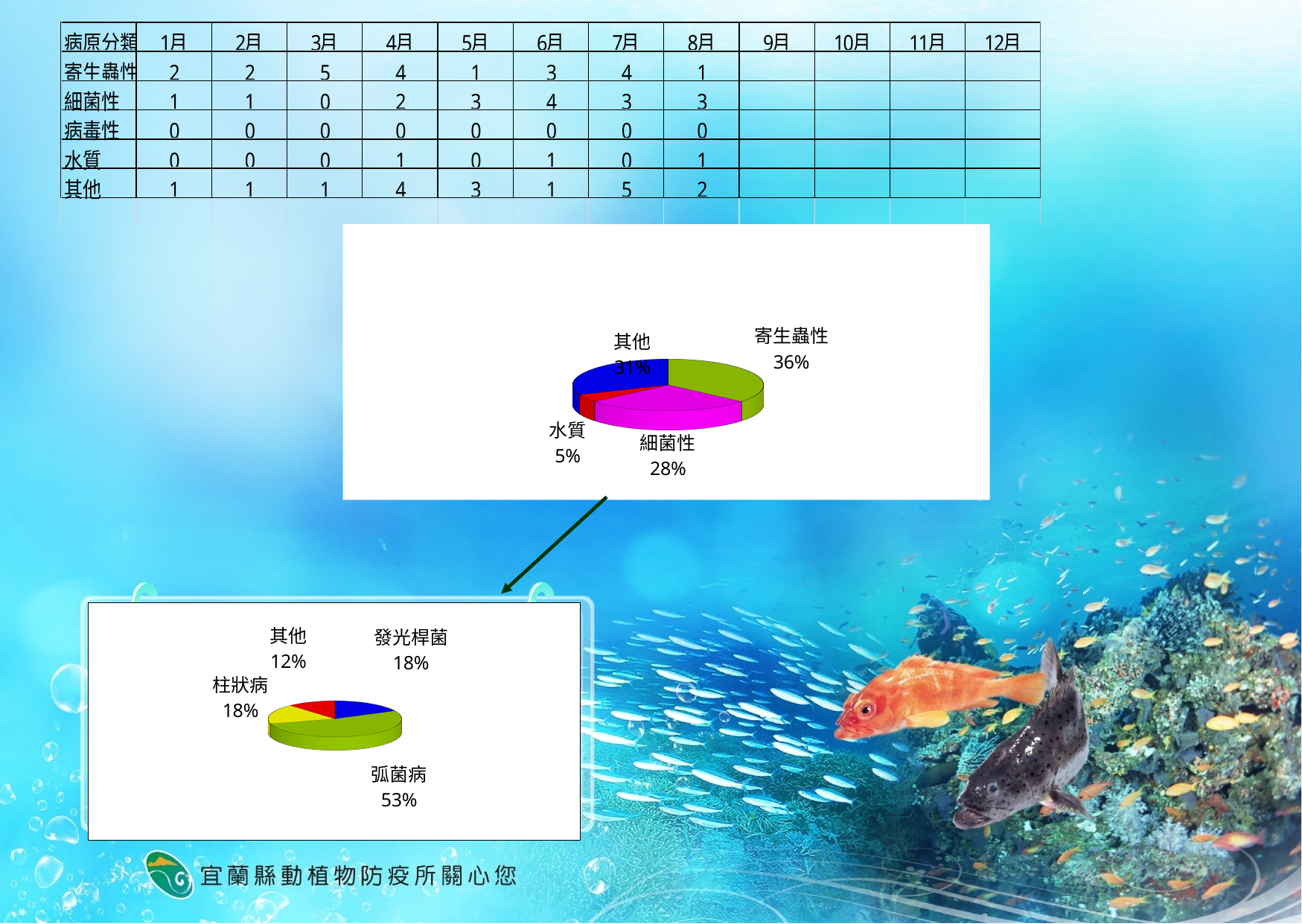
In the upper pie chart in the centre of the slide, which category has the largest share? 寄生蟲性 In the lower pie chart at the bottom left of the slide, which is larger, 發光桿菌 or 其他? 發光桿菌 In the lower pie chart at the bottom left of the slide, which category has the largest share? 弧菌病 In the upper pie chart in the centre of the slide, how many slices are there? 4 In the upper pie chart in the centre of the slide, what share does 水質 have? 5% In the lower pie chart at the bottom left of the slide, what share does 其他 have? 12% In the upper pie chart in the centre of the slide, which category has the smallest share? 水質 In the upper pie chart in the centre of the slide, what share does 寄生蟲性 have? 36% What kind of chart is the lower chart at the bottom left of the slide? Pie chart In the upper pie chart in the centre of the slide, what is the difference in percentage points between 寄生蟲性 and 細菌性? 8